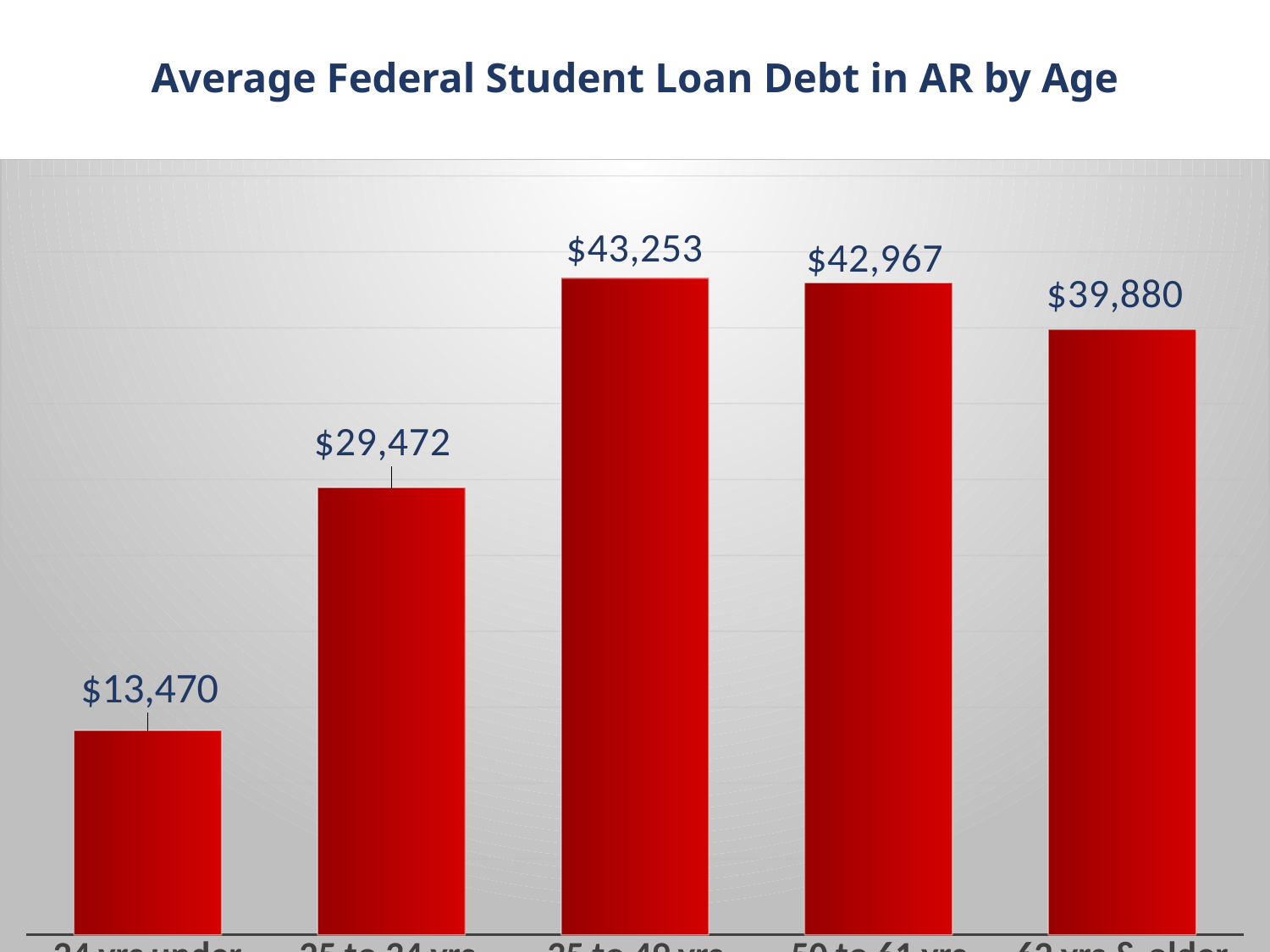
What is the value of the fourth bar from the left? $42,967 What is the lowest value shown in the chart? $13,470 What is the title of the chart? Average Federal Student Loan Debt in AR by Age How many bars are shown in the chart? 5 What is the difference between the second bar ($29,472) and the first bar ($13,470)? $16,002 What is the difference between the highest value ($43,253) and the lowest value ($13,470)? $29,783 What is the value of the last (rightmost) bar? $39,880 What is the value of the middle (third) bar? $43,253 What is the value of the second bar from the left? $29,472 What is the value of the first (leftmost) bar in the chart? $13,470 What is the highest value shown in the chart? $43,253 Which is larger, the value of the second bar or the value of the rightmost bar? The rightmost bar ($39,880)